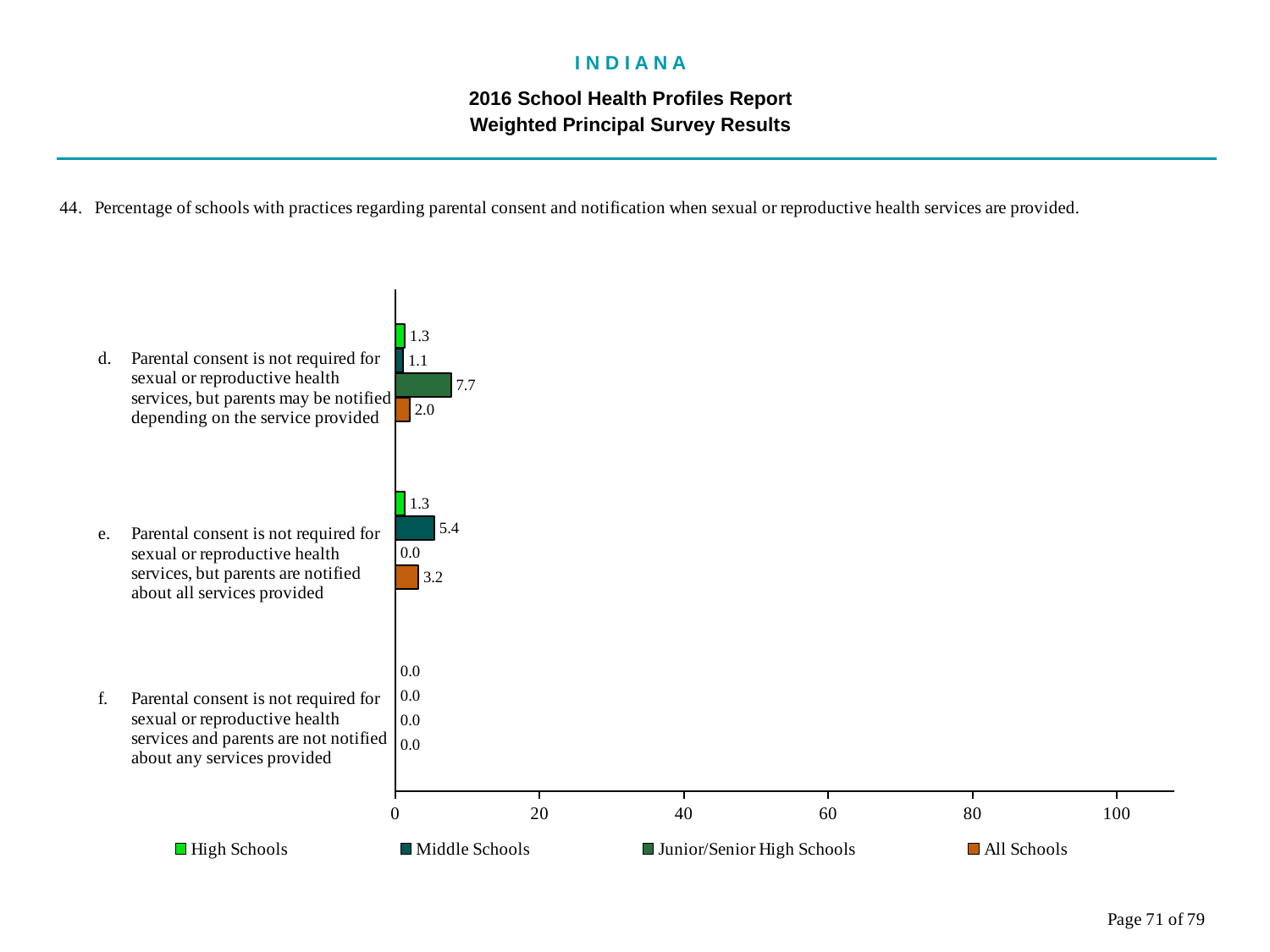
For category e, which is larger: the Middle Schools value or the All Schools value? Middle Schools What is the value for All Schools for category d? 2.0 What is the value for High Schools for category e? 1.3 What is the difference between the Junior/Senior High Schools value and the All Schools value for category d? 5.7 What is the maximum value shown on the horizontal axis? 100 What type of chart is shown on the slide? Bar chart What is the value for Middle Schools for category e (parental consent not required, but parents are notified about all services provided)? 5.4 What is the value for Junior/Senior High Schools for category d (parental consent not required, but parents may be notified depending on the service provided)? 7.7 How many series does the legend list? 4 Which series has the lowest value for category e? Junior/Senior High Schools Which series has the highest value for category d? Junior/Senior High Schools What is the value for All Schools for category f (parents are not notified about any services provided)? 0.0